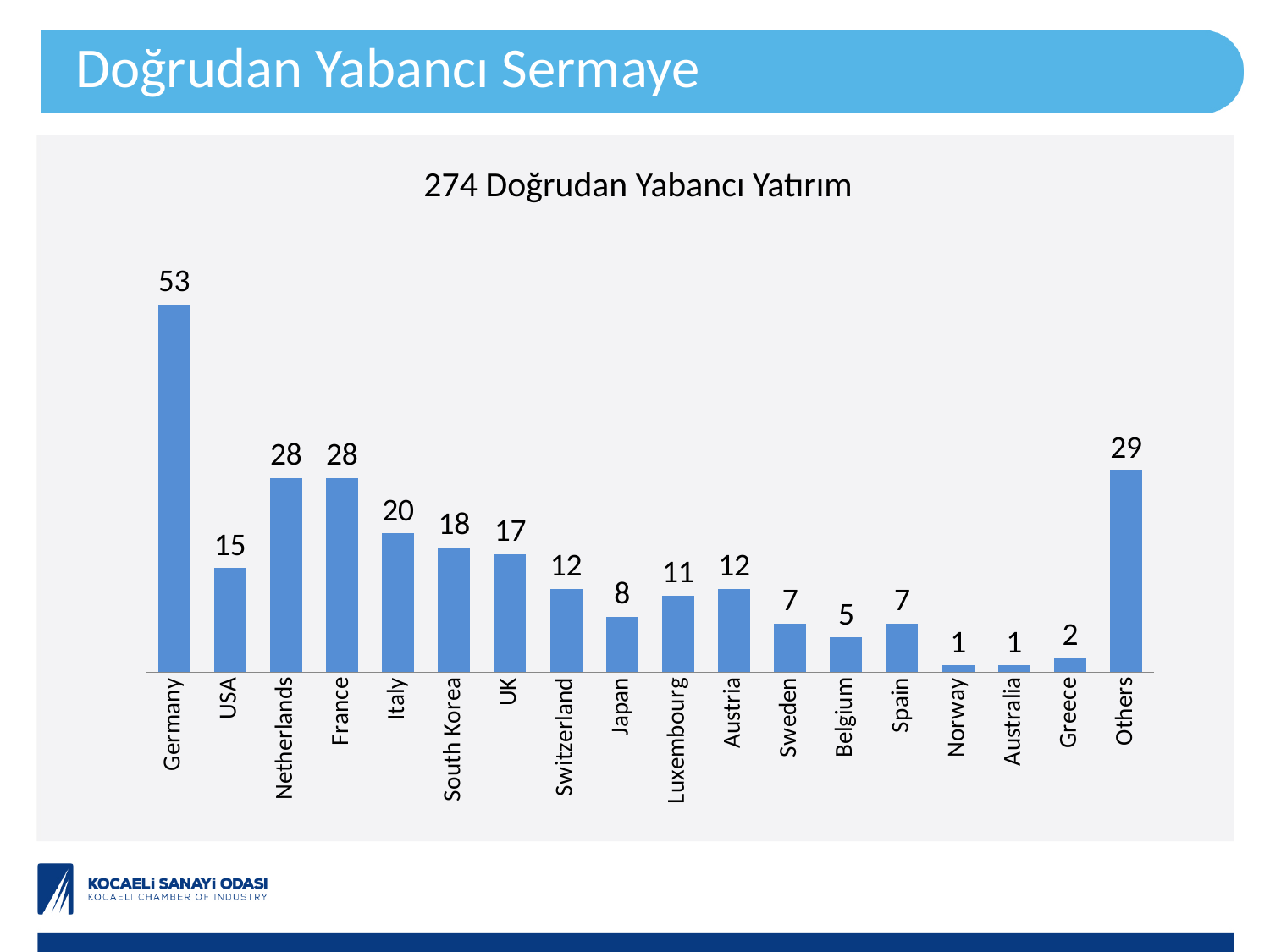
What kind of chart is shown on the slide? Bar chart What is the value for Luxembourg? 11 Which country has the highest value? Germany What is the difference between the values for Italy and UK? 3 Which is larger, the value for USA or the value for Japan? USA What is the value for Germany? 53 What is the difference between the values for Germany and Others? 24 What is the title of the chart? 274 Doğrudan Yabancı Yatırım Which is larger, the value for Belgium or the value for Sweden? Sweden What is the value for Others? 29 What is the value for South Korea? 18 How many categories are shown on the x axis? 18